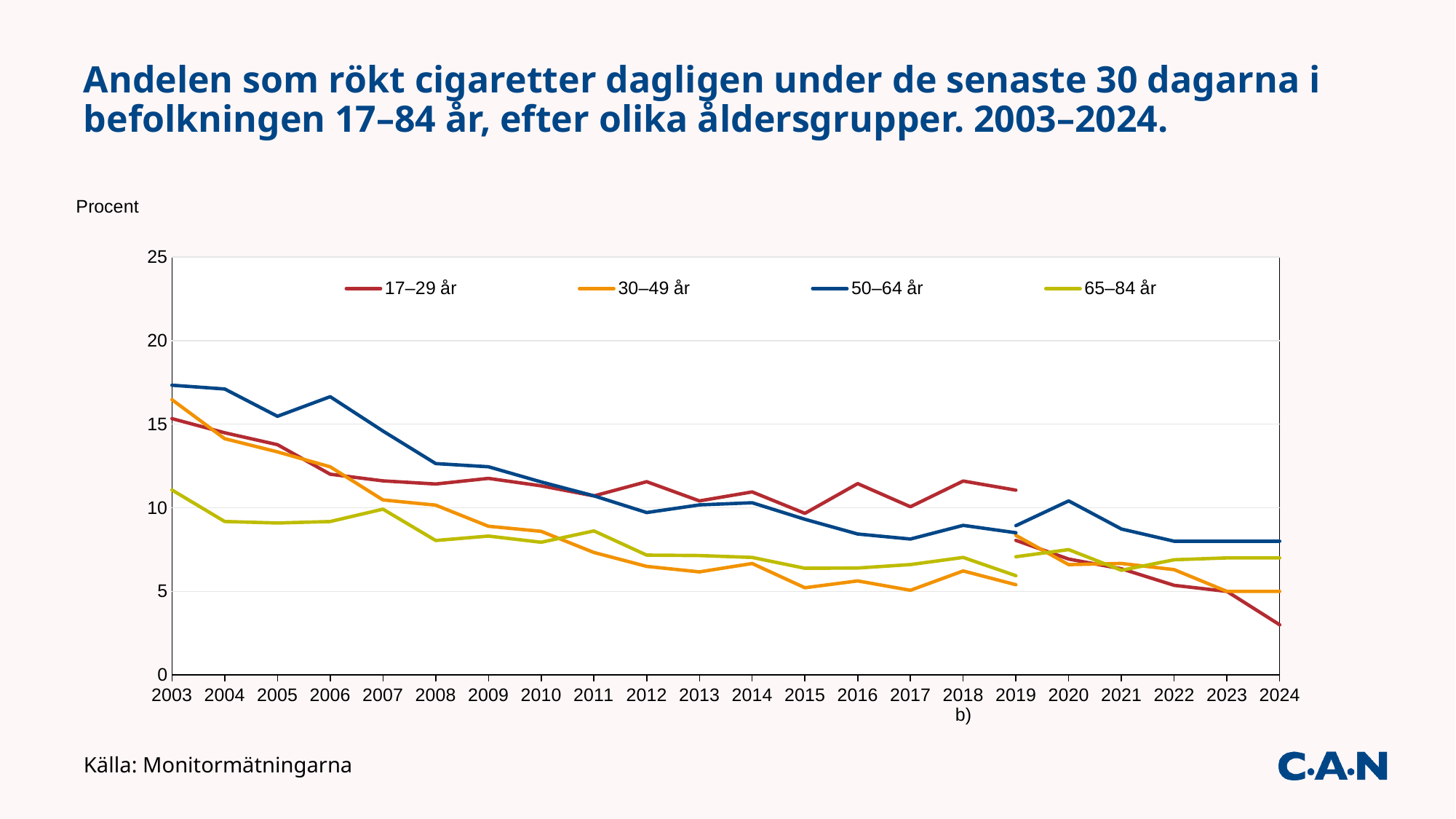
Does the value for 50–64 år rise or fall from 2003 to 2024? fall Is the value for 50–64 år in 2003 greater or less than 15? greater Is the value for 17–29 år in 2024 greater or less than 5? less Which age group has the lowest value in 2024? 17–29 år Is the value for 65–84 år in 2008 greater or less than 10? less What kind of chart is shown on the slide? line chart How many series does the legend list? 4 Which age group has the highest value in 2003? 50–64 år What is the label on the vertical axis? Procent How many years are shown on the x axis? 22 Which age group has the lowest value in 2003? 65–84 år Which is larger in 2003, the value for 17–29 år or the value for 65–84 år? 17–29 år